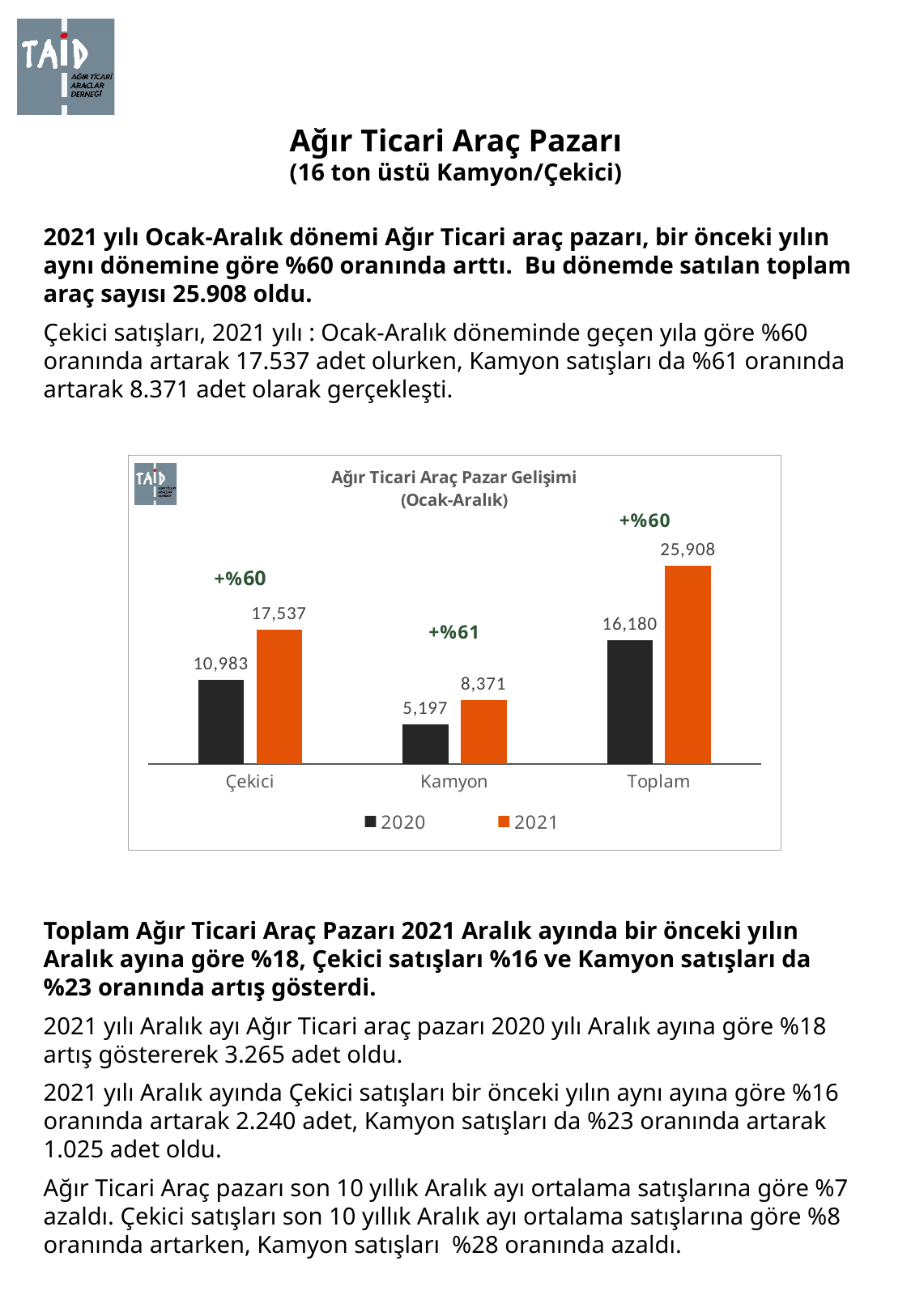
What is the 2021 value for Toplam? 25,908 Which category has the lowest 2021 value? Kamyon How many series does the legend list? 2 How many categories are shown on the x axis? 3 What type of chart is shown? Bar chart What is the 2021 value for Çekici? 17,537 What is the 2020 value for Çekici? 10,983 Which category has the highest 2020 value? Toplam Which is larger: the 2020 value for Toplam or the 2021 value for Çekici? 2021 value for Çekici What is the difference between the 2021 and 2020 values for Toplam? 9,728 What is the difference between the 2021 and 2020 values for Kamyon? 3,174 What is the 2020 value for Kamyon? 5,197